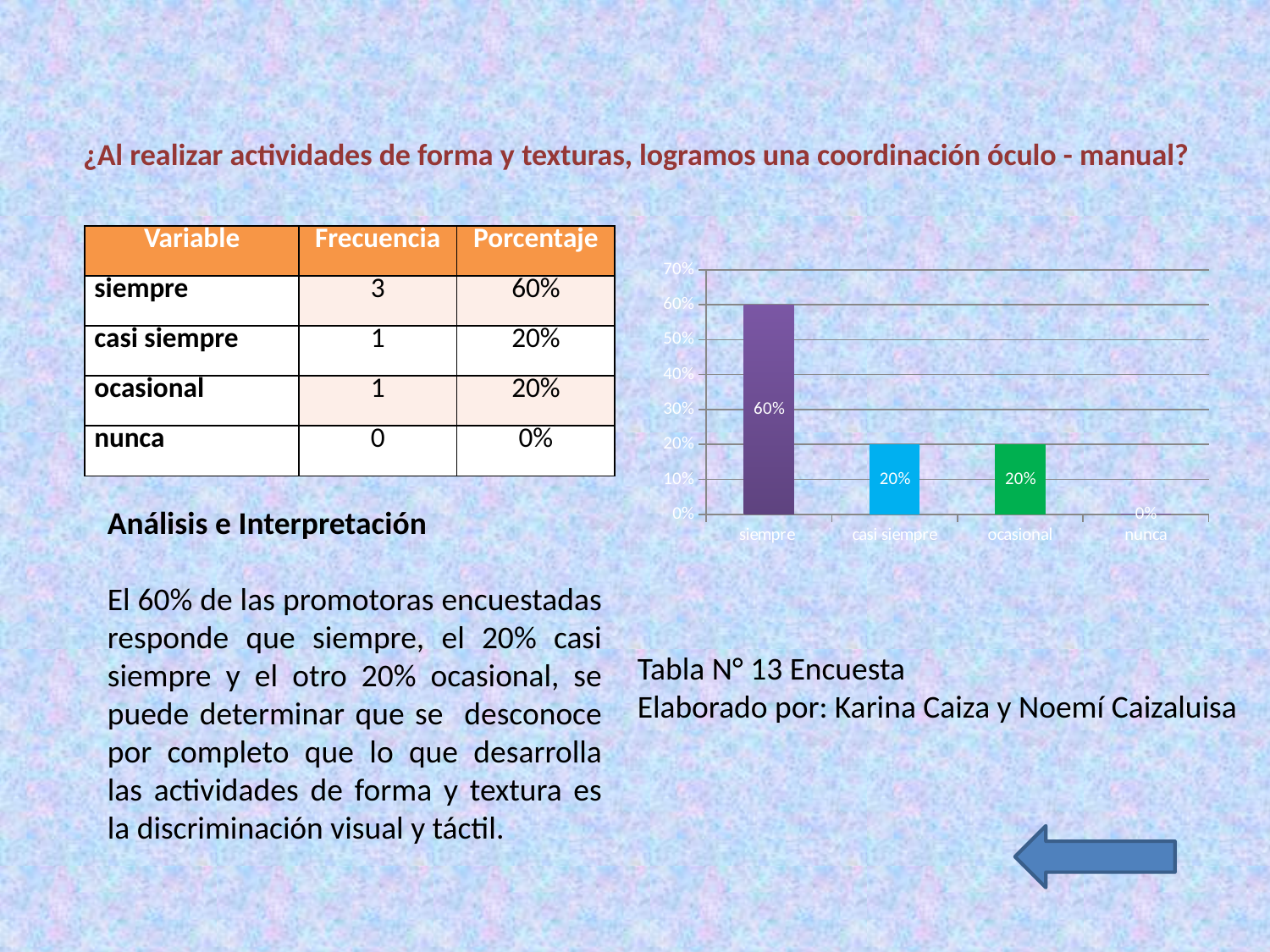
Is the value for siempre greater or less than 50%? greater What is the value for siempre in the chart? 60% What is the value for nunca in the chart? 0% What kind of chart is shown on the slide? bar chart What is the highest value shown on the chart's y axis? 70% What is the value for casi siempre in the chart? 20% Which category has the lowest value in the chart? nunca How many categories are shown on the x axis of the chart? 4 What colour is the bar for ocasional? green What is the difference between the values for siempre and ocasional? 40% Which category has the highest value in the chart? siempre Which is larger, the value for siempre or the value for casi siempre? siempre